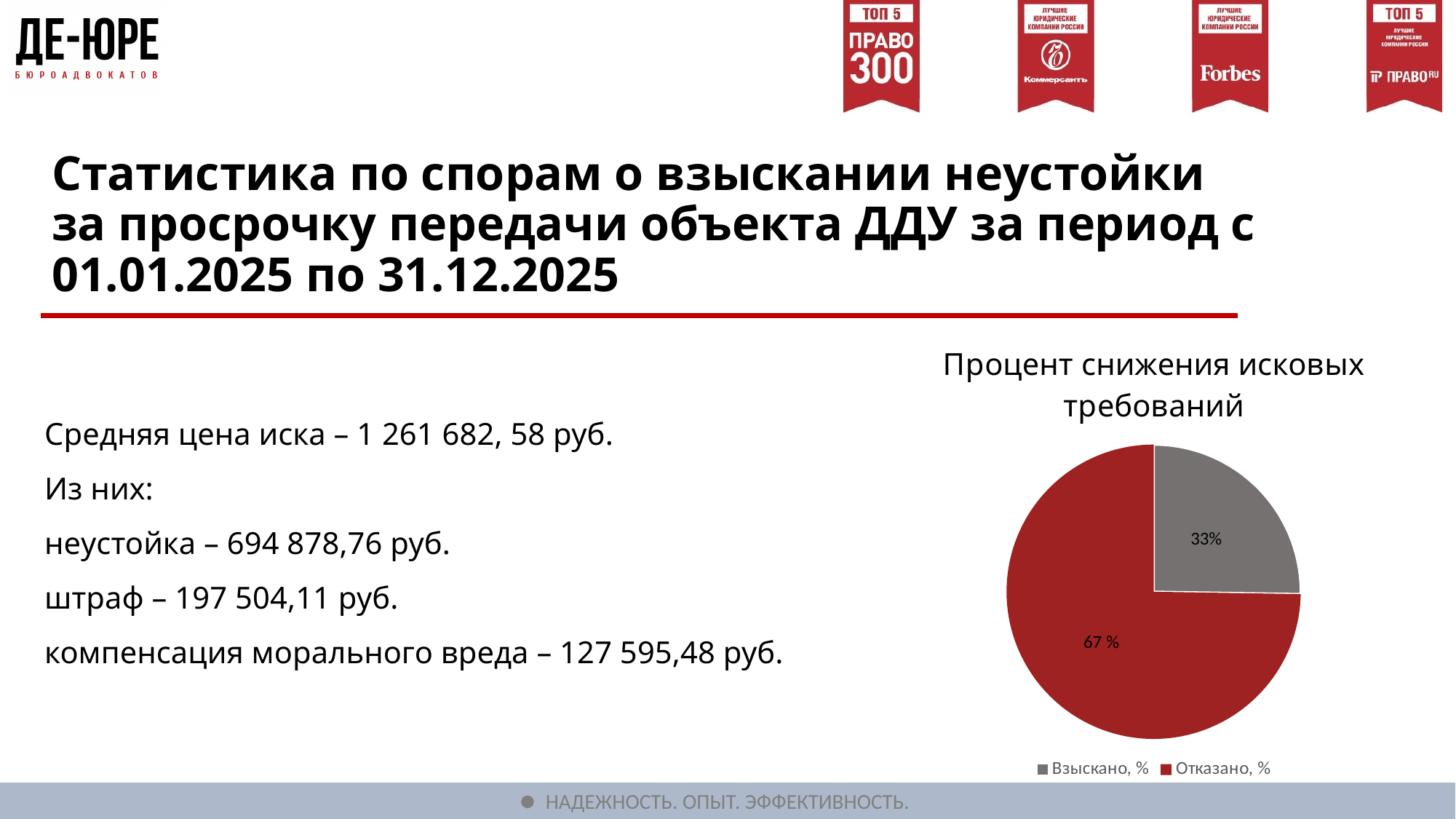
How many slices does the pie chart have? 2 Which slice of the pie is the largest? Отказано, % Which slice of the pie is the smallest? Взыскано, % What is the value shown for the "Отказано, %" slice? 67 % What is the value shown for the "Взыскано, %" slice? 33% What colour is the "Отказано, %" slice? Red What kind of chart is shown on the slide? Pie chart How many entries does the legend list? 2 What is the difference between the "Отказано, %" and "Взыскано, %" values? 34 Which is larger, the "Взыскано, %" slice or the "Отказано, %" slice? Отказано, % What is the title of the chart? Процент снижения исковых требований